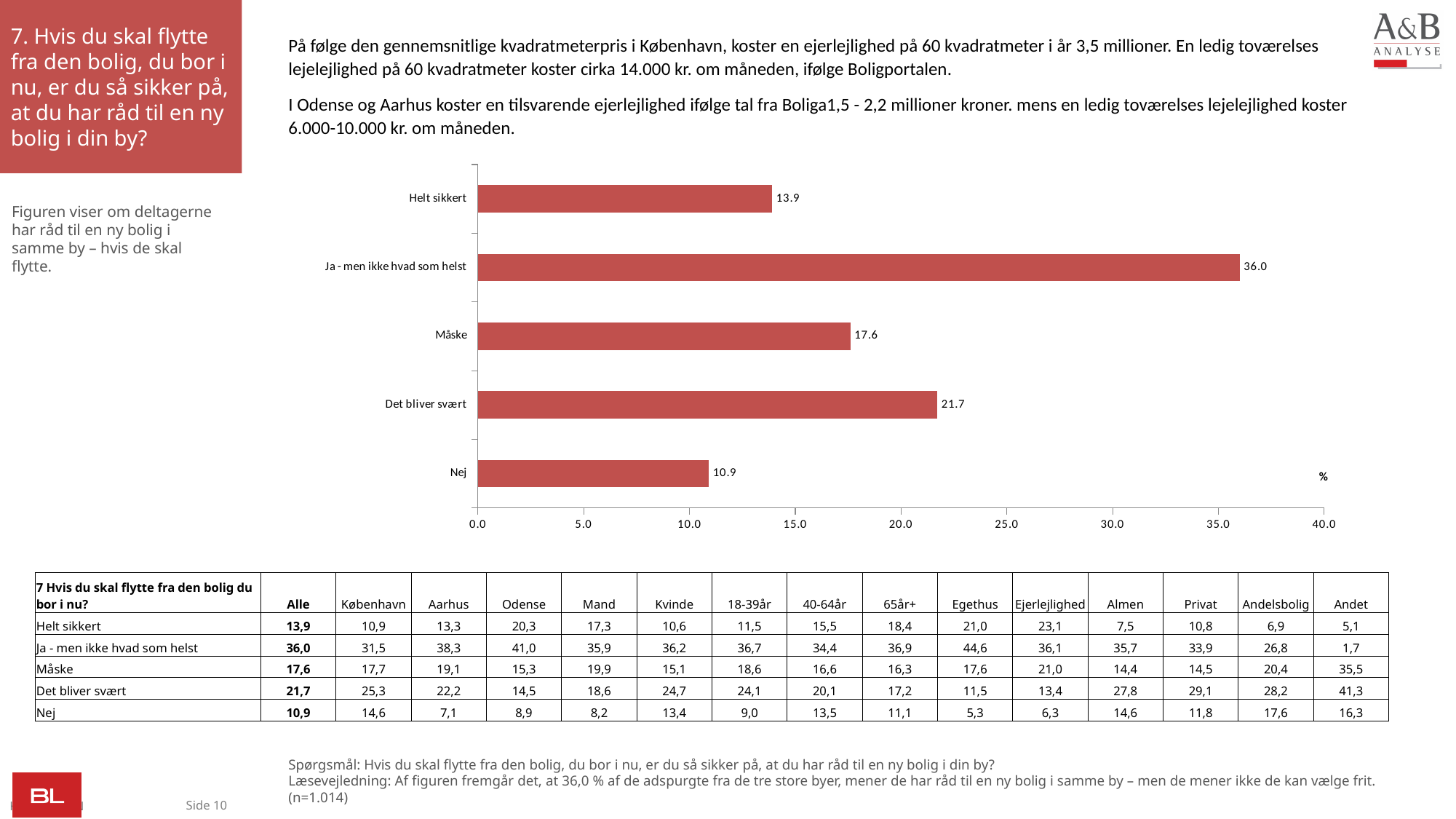
What value is shown for "Nej" in the bar chart? 10.9 How many categories are shown in the bar chart? 5 Which category has the highest value in the bar chart? Ja - men ikke hvad som helst Is the value for "Det bliver svært" greater or less than 20.0? greater Which has a larger value in the bar chart, "Måske" or "Det bliver svært"? Det bliver svært What is the difference between the values for "Ja - men ikke hvad som helst" and "Det bliver svært" in the bar chart? 14.3 Which category has the lowest value in the bar chart? Nej What value is shown for "Måske" in the bar chart? 17.6 What kind of chart is shown on the slide? bar chart What is the maximum value shown on the horizontal axis of the bar chart? 40.0 What value is shown for "Ja - men ikke hvad som helst" in the bar chart? 36.0 What value is shown for "Helt sikkert" in the bar chart? 13.9